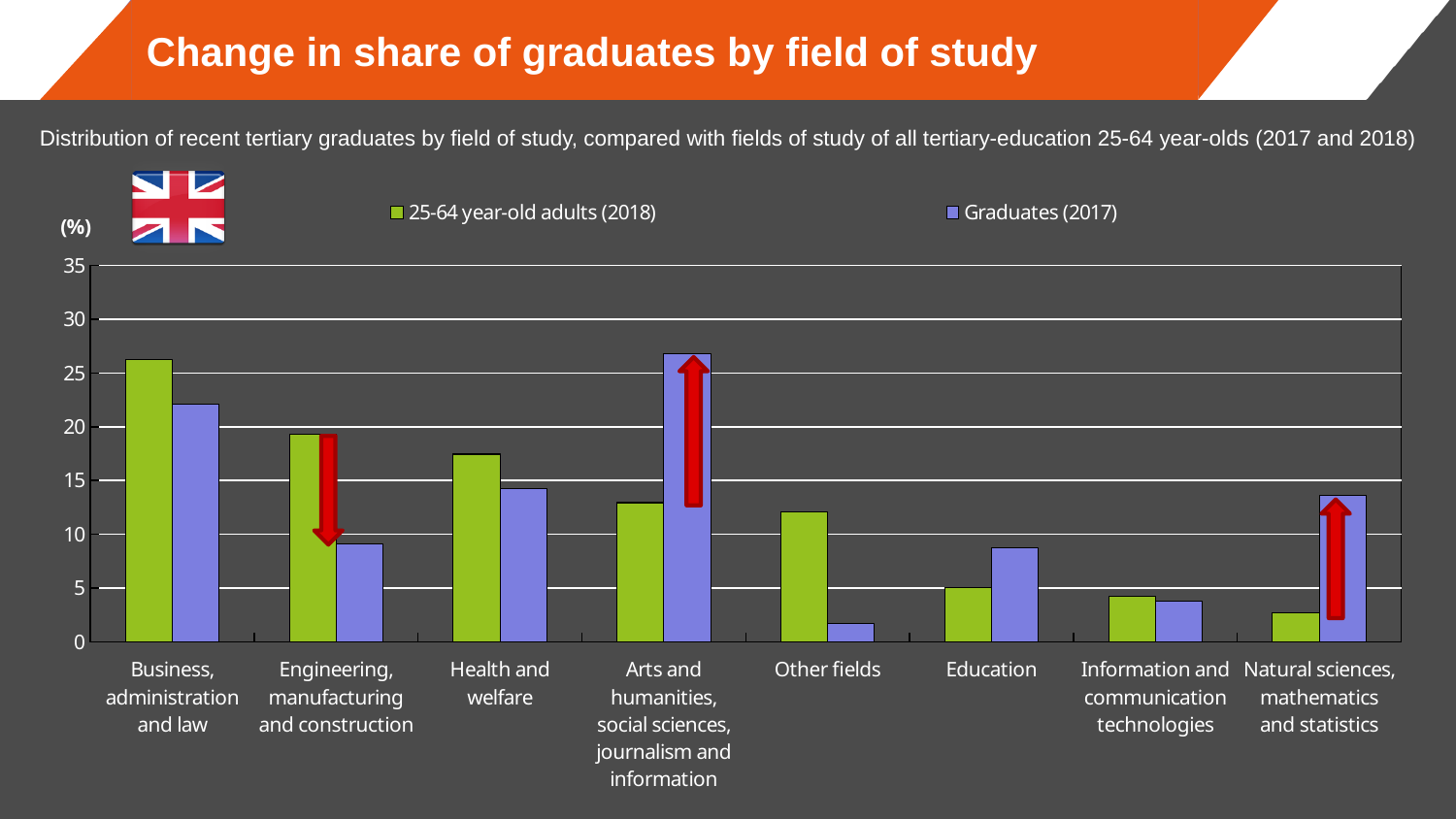
Which field of study has the highest value for Graduates (2017)? Arts and humanities, social sciences, journalism and information How many fields of study are shown on the x axis? 8 For Engineering, manufacturing and construction, which is larger: 25-64 year-old adults (2018) or Graduates (2017)? 25-64 year-old adults (2018) Which field of study has the highest value for 25-64 year-old adults (2018)? Business, administration and law For Natural sciences, mathematics and statistics, which is larger: 25-64 year-old adults (2018) or Graduates (2017)? Graduates (2017) Is the value for Graduates (2017) in Other fields greater or less than 5? less Which field of study has the lowest value for Graduates (2017)? Other fields What kind of chart is shown on the slide? Bar chart How many series does the legend list? 2 Is the value for 25-64 year-old adults (2018) in Business, administration and law greater or less than 20? greater Which field of study has the lowest value for 25-64 year-old adults (2018)? Natural sciences, mathematics and statistics Is the value for Graduates (2017) in Arts and humanities, social sciences, journalism and information greater or less than 25? greater